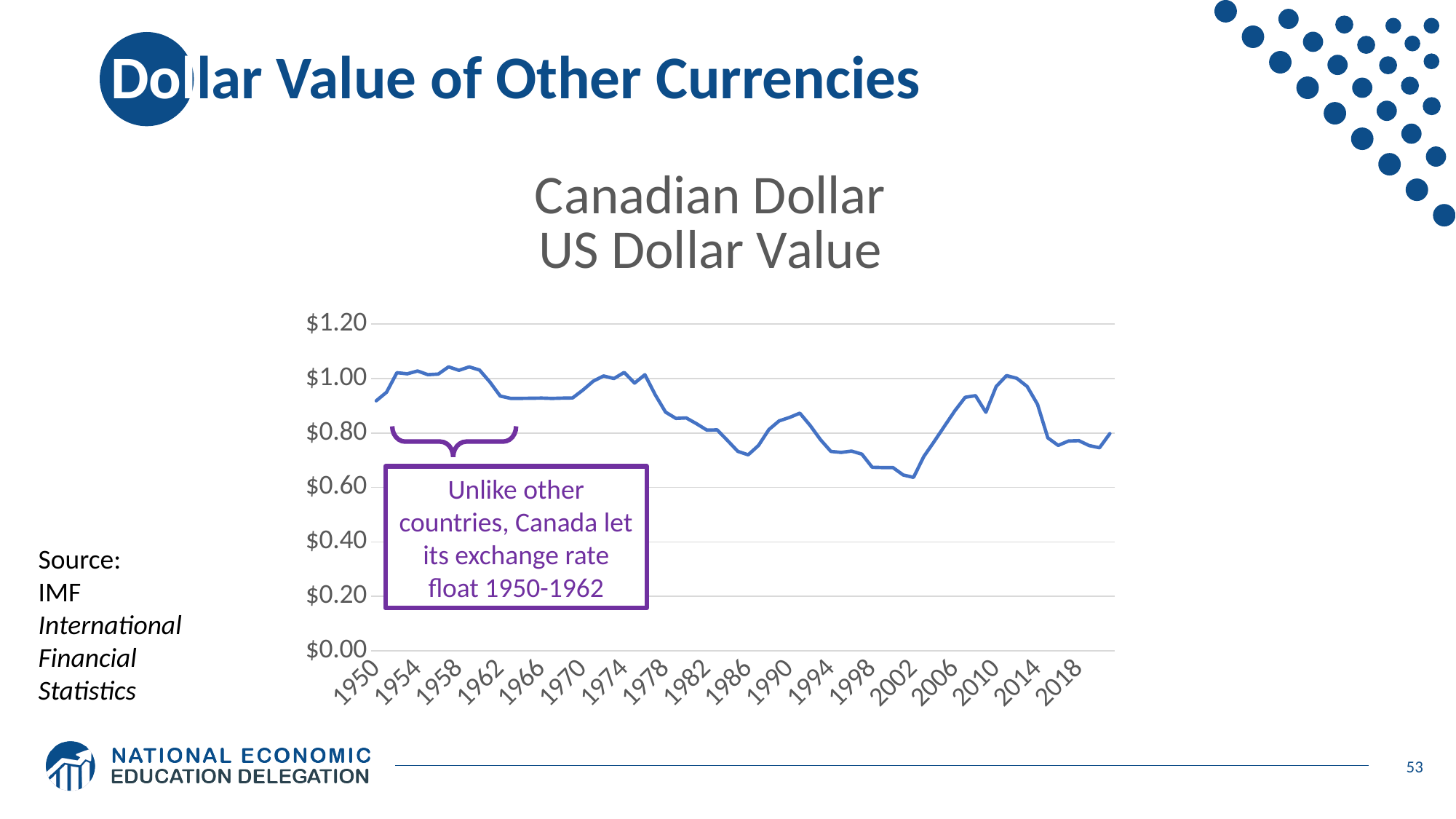
Is the value for 1966 greater or less than $1.00? less Is the value for 2002 greater or less than $0.60? greater Which year has the larger value, 1958 or 2002? 1958 Do the values rise or fall between 2002 and 2010? rise What kind of chart is shown on the slide? Line chart Is the value for 1986 greater or less than $0.80? less What is the title of the chart? Canadian Dollar US Dollar Value Do the values rise or fall between 1974 and 1986? fall According to the annotation on the chart, during which years did Canada let its exchange rate float? 1950-1962